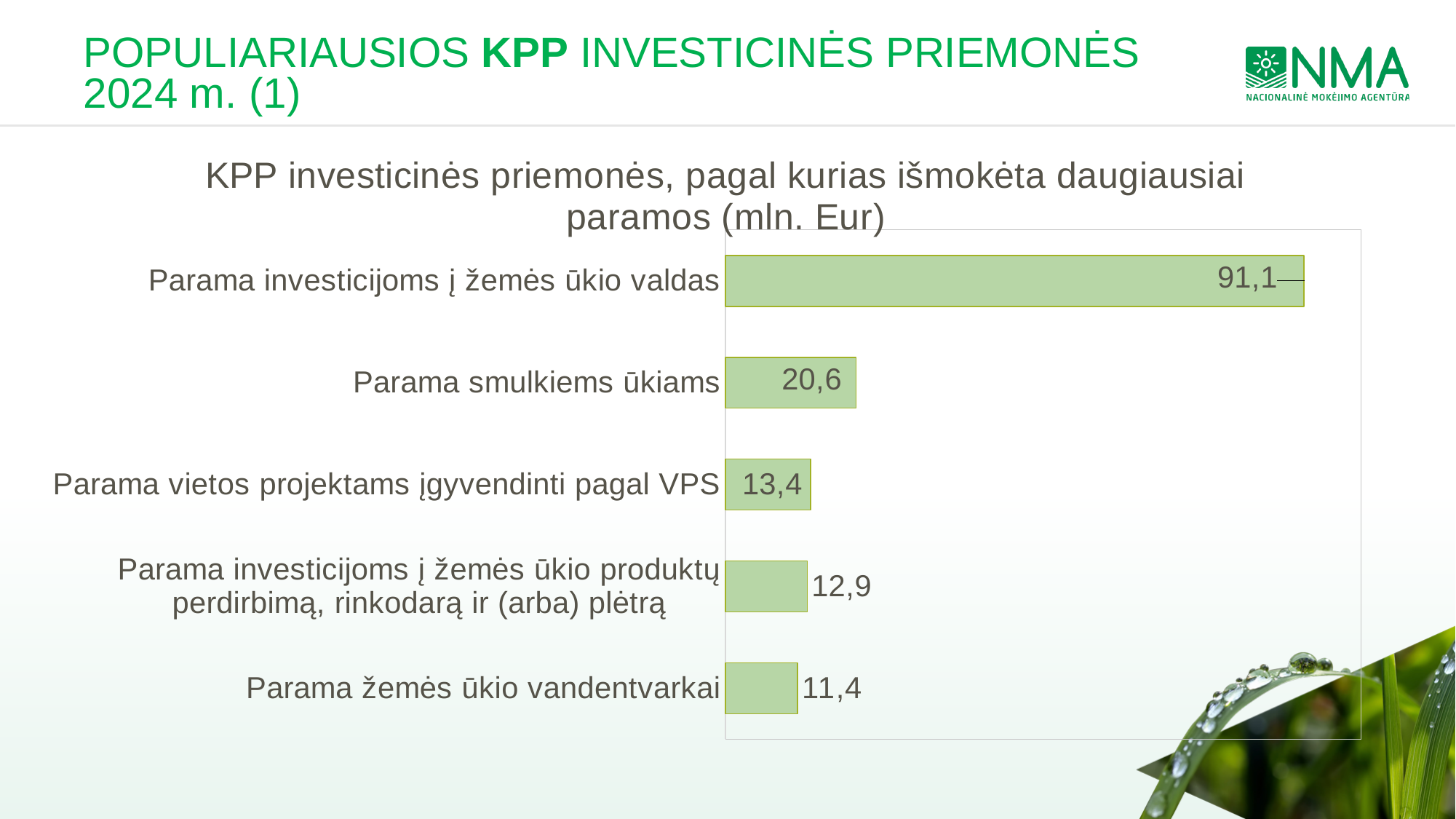
What kind of chart is shown on the slide? Bar chart How many categories are shown in the chart? 5 Which is larger: the value for Parama smulkiems ūkiams or the value for Parama investicijoms į žemės ūkio produktų perdirbimą, rinkodarą ir (arba) plėtrą? Parama smulkiems ūkiams What is the value for Parama žemės ūkio vandentvarkai? 11,4 What is the title of the chart? KPP investicinės priemonės, pagal kurias išmokėta daugiausiai paramos (mln. Eur) Which category has the lowest value? Parama žemės ūkio vandentvarkai Which category has the highest value? Parama investicijoms į žemės ūkio valdas What is the difference between the values for Parama vietos projektams įgyvendinti pagal VPS and Parama žemės ūkio vandentvarkai? 2,0 What is the difference between the values for Parama investicijoms į žemės ūkio valdas and Parama smulkiems ūkiams? 70,5 What is the value for Parama smulkiems ūkiams? 20,6 What is the value for Parama investicijoms į žemės ūkio valdas? 91,1 What is the value for Parama vietos projektams įgyvendinti pagal VPS? 13,4